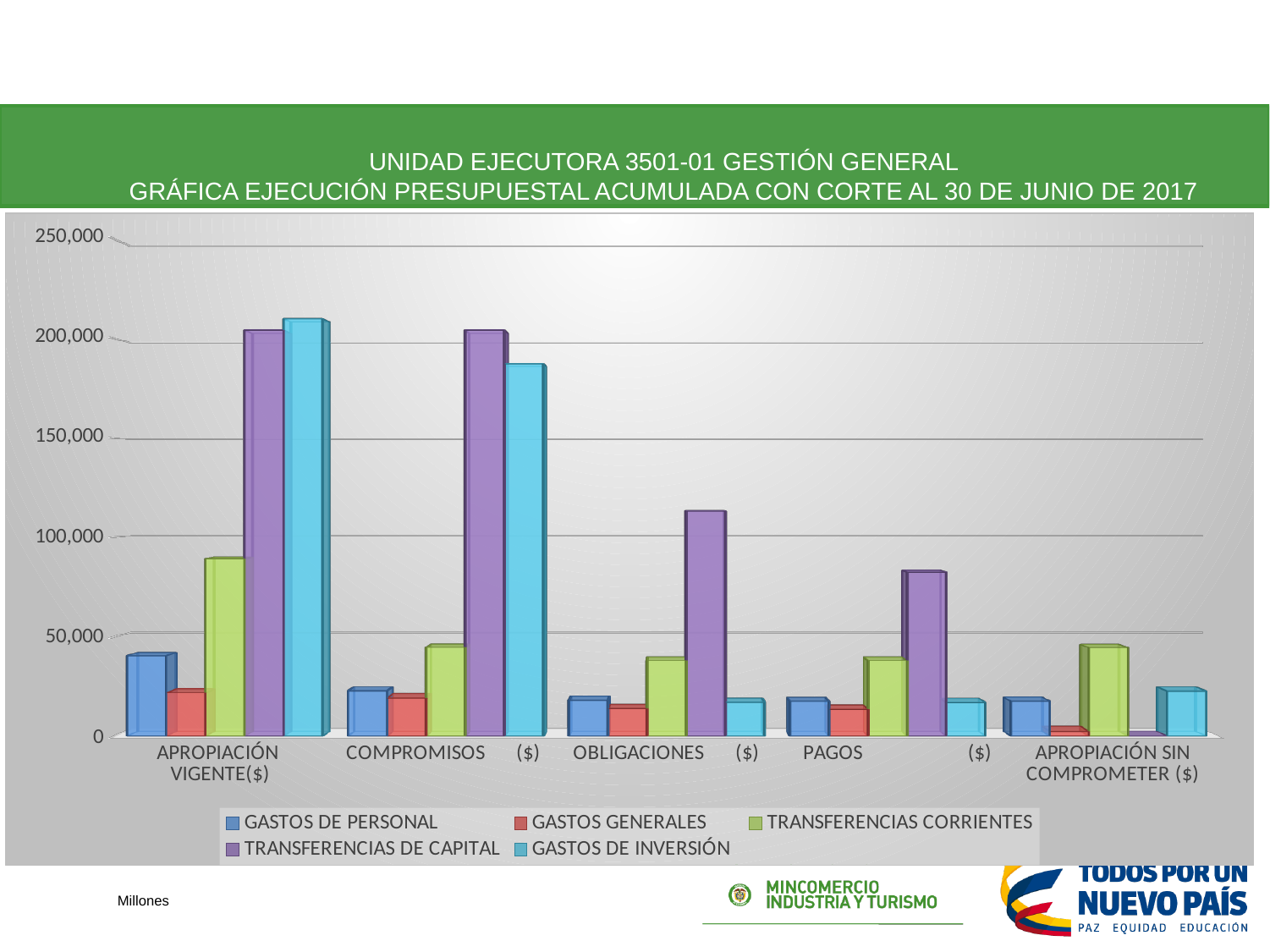
Is the value of TRANSFERENCIAS DE CAPITAL for PAGOS ($) greater or less than 100,000? less How many series does the legend list? 5 How many categories are shown along the x axis? 5 Which series has the lowest value in the APROPIACIÓN SIN COMPROMETER ($) category? TRANSFERENCIAS DE CAPITAL Is the value of GASTOS DE PERSONAL for APROPIACIÓN VIGENTE($) greater or less than 50,000? less Which colour represents GASTOS GENERALES in the legend? red Is the value of GASTOS DE INVERSIÓN for APROPIACIÓN VIGENTE($) greater or less than 200,000? greater What kind of chart is shown on the slide? bar chart Which series has the highest value in the OBLIGACIONES ($) category? TRANSFERENCIAS DE CAPITAL Is the GASTOS DE INVERSIÓN value larger for APROPIACIÓN VIGENTE($) or for COMPROMISOS ($)? APROPIACIÓN VIGENTE($)